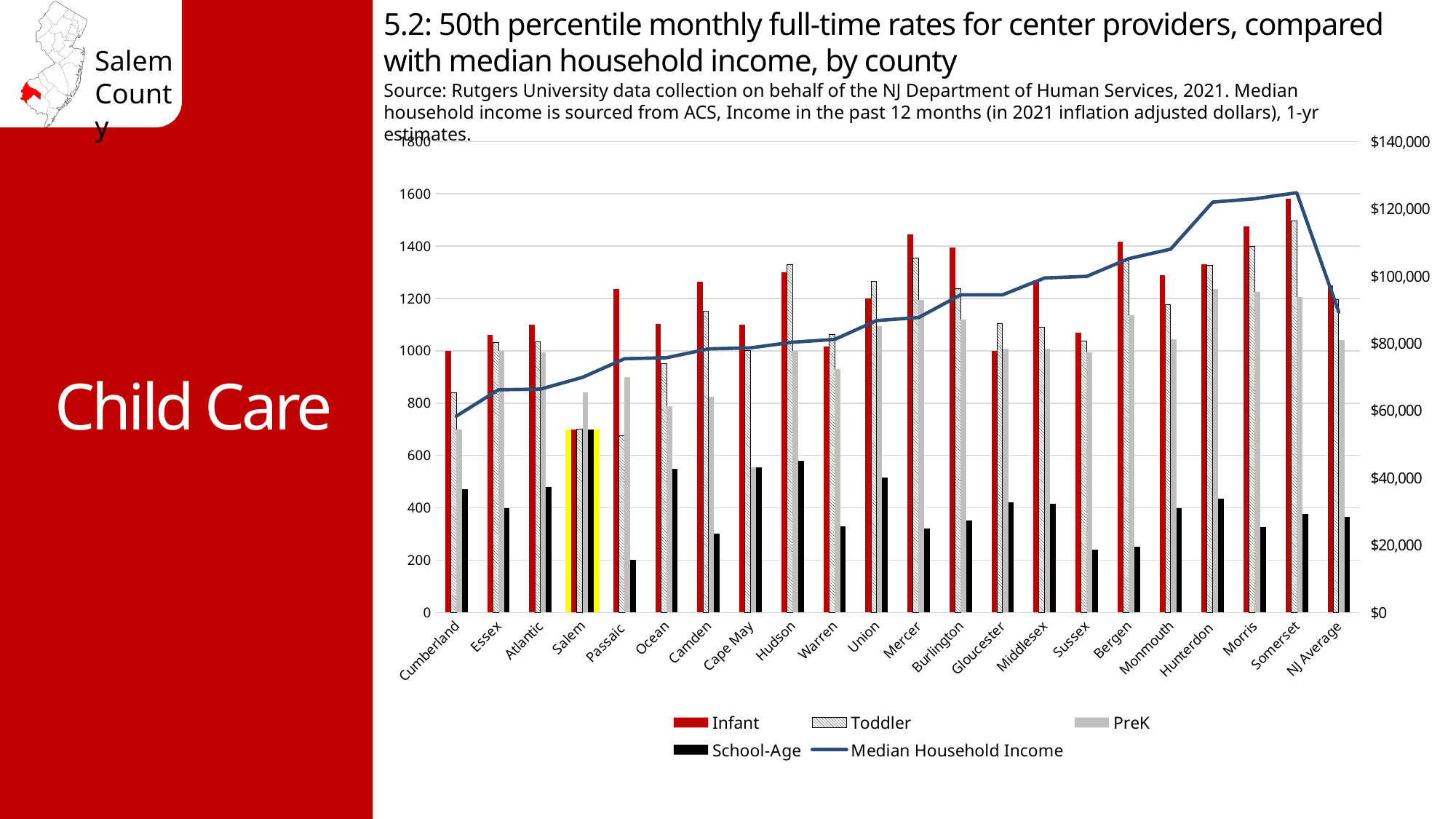
How many series does the chart legend list? 5 Which county has the lowest Median Household Income? Cumberland Is the Infant rate for Somerset greater or less than 1400? greater How many counties or categories are shown along the x axis of the chart? 22 Is the Median Household Income for Cumberland greater or less than $80,000? less Which county has the highest Median Household Income? Somerset What kind of chart is used on this slide? Bar chart with a line series Which county has the lowest School-Age rate? Passaic Which county has the highest Infant rate? Somerset Which is larger, the Toddler rate for Hudson or the Toddler rate for Salem? Hudson Does the Median Household Income line generally rise or fall from Cumberland to Somerset? rise Is the Infant rate for Salem greater or less than 800? less